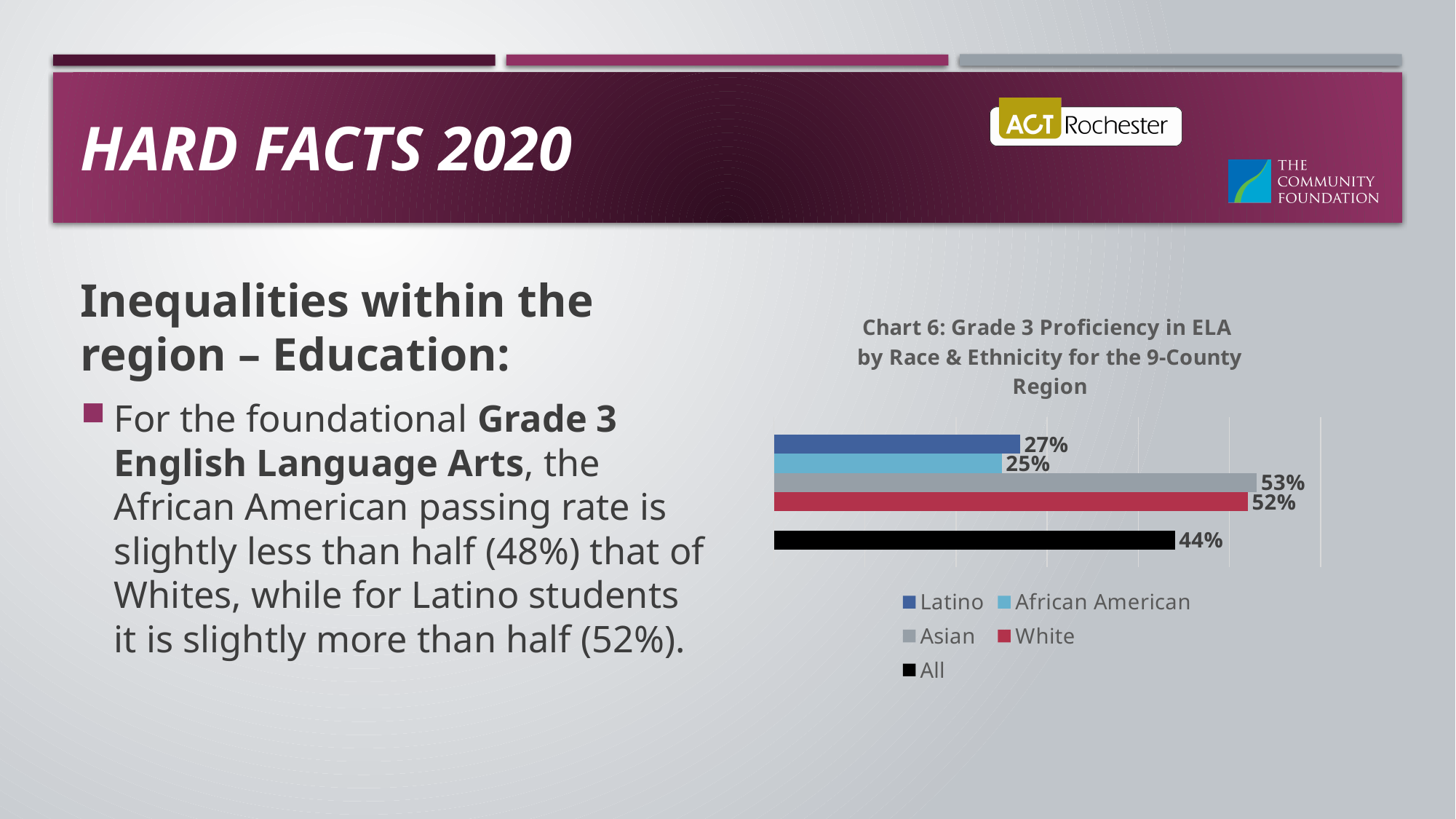
What is the difference between the White and African American proficiency rates? 27% What is the Grade 3 ELA proficiency rate for Asian students? 53% What is the Grade 3 ELA proficiency rate for African American students? 25% Which is larger, the proficiency rate for All students or for Latino students? All What is the title of the chart? Chart 6: Grade 3 Proficiency in ELA by Race & Ethnicity for the 9-County Region How many series does the legend list? 5 What is the Grade 3 ELA proficiency rate for Latino students? 27% What is the difference between the Latino and African American proficiency rates? 2% What kind of chart is shown? Bar chart Which group has the lowest Grade 3 ELA proficiency rate? African American What is the Grade 3 ELA proficiency rate for White students? 52% What is the Grade 3 ELA proficiency rate for All students? 44%